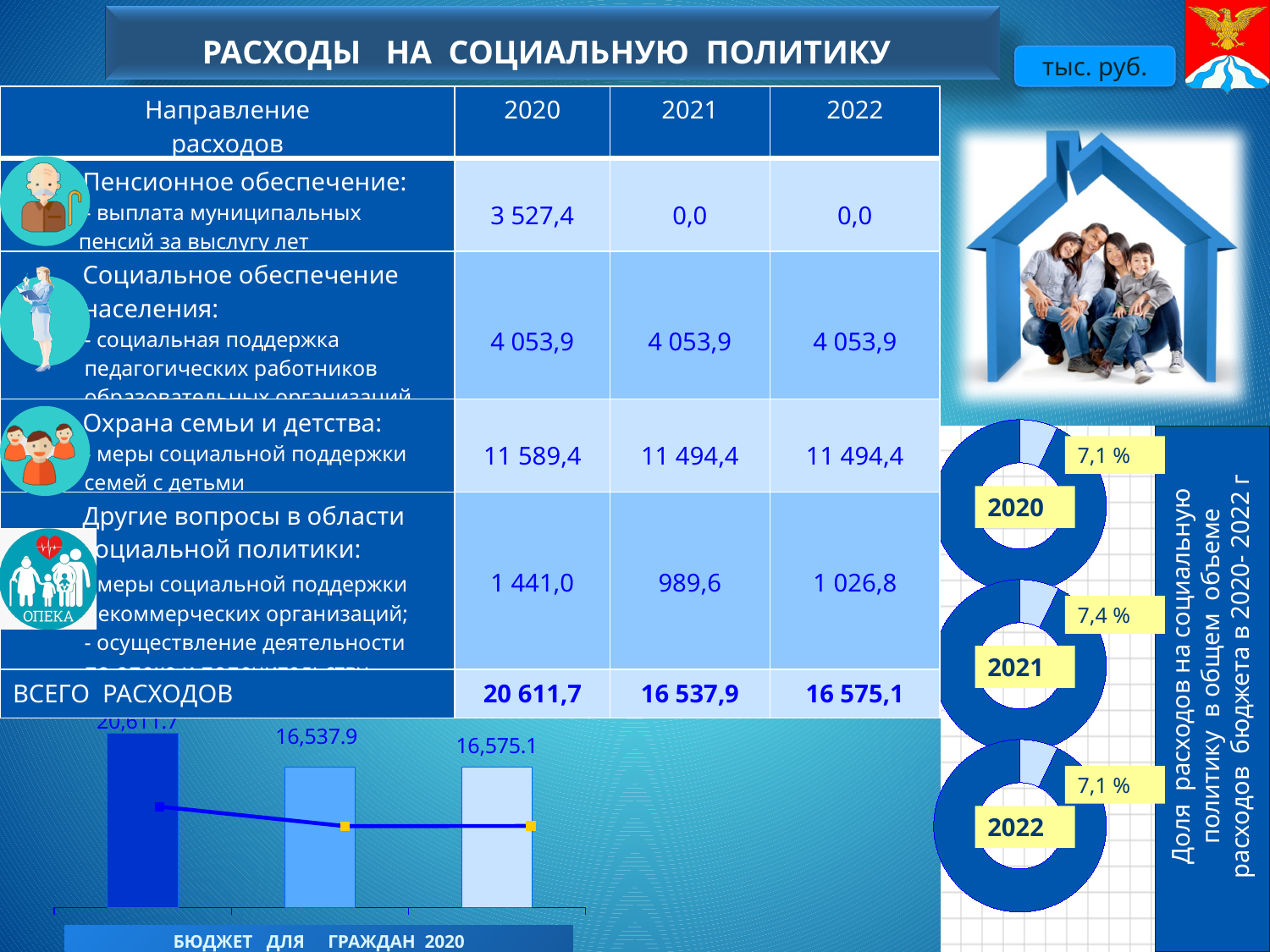
In the bar chart at the bottom left, which bar is the lowest? the second bar (16,537.9) In the bar chart at the bottom left, what is the difference between the first bar (20,611.7) and the second bar (16,537.9)? 4,073.8 In the bar chart at the bottom left, what is the value labelled on the first bar? 20,611.7 In the bar chart at the bottom left, what is the value labelled on the third bar? 16,575.1 In the donut charts on the right, what share is shown for 2020? 7,1 % In the donut charts on the right, what share is shown for 2021? 7,4 % In the donut charts on the right, which year has the largest share? 2021 What kind of chart is shown at the bottom left of the slide? bar chart In the bar chart at the bottom left, how many bars are plotted? 3 In the bar chart at the bottom left, what is the difference between the third bar (16,575.1) and the second bar (16,537.9)? 37.2 In the bar chart at the bottom left, which bar is the tallest? the first bar (20,611.7) In the bar chart at the bottom left, what is the value labelled on the second bar? 16,537.9